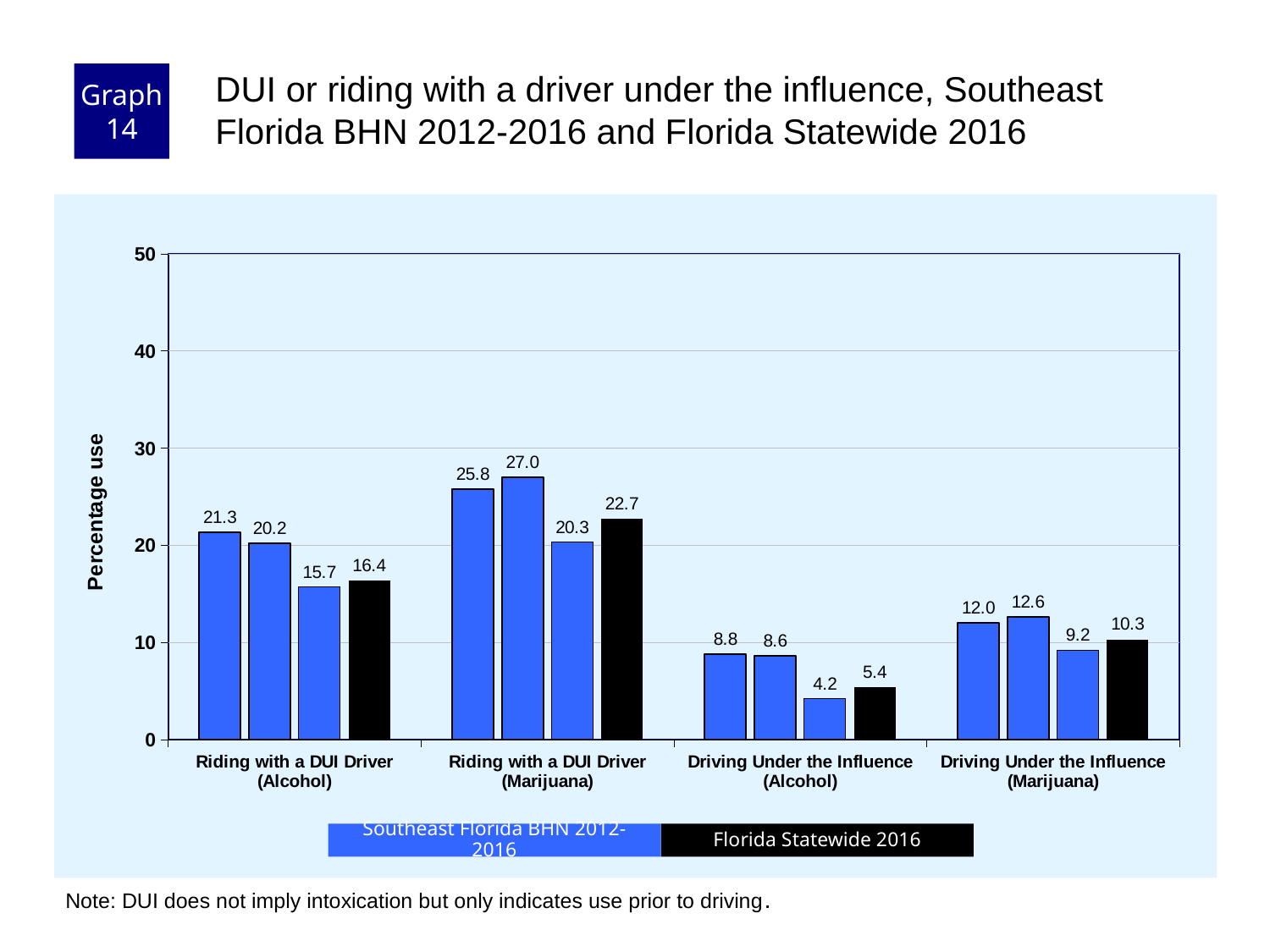
Is the Florida Statewide 2016 value for Riding with a DUI Driver (Marijuana) greater or less than 20? greater How many categories are shown on the x axis? 4 What is the value of the tallest bar in the Driving Under the Influence (Marijuana) group? 12.6 What is the difference between the Florida Statewide 2016 values for Riding with a DUI Driver (Alcohol) and Driving Under the Influence (Alcohol)? 11.0 What is the title of the y axis? Percentage use What kind of chart is shown on the slide? bar chart Which has the larger Florida Statewide 2016 value: Riding with a DUI Driver (Alcohol) or Riding with a DUI Driver (Marijuana)? Riding with a DUI Driver (Marijuana) What is the Florida Statewide 2016 value for Riding with a DUI Driver (Marijuana)? 22.7 What is the lowest value shown on the chart? 4.2 Which category contains the tallest bar on the chart? Riding with a DUI Driver (Marijuana) What is the Florida Statewide 2016 value for Driving Under the Influence (Alcohol)? 5.4 How many series does the legend list? 2